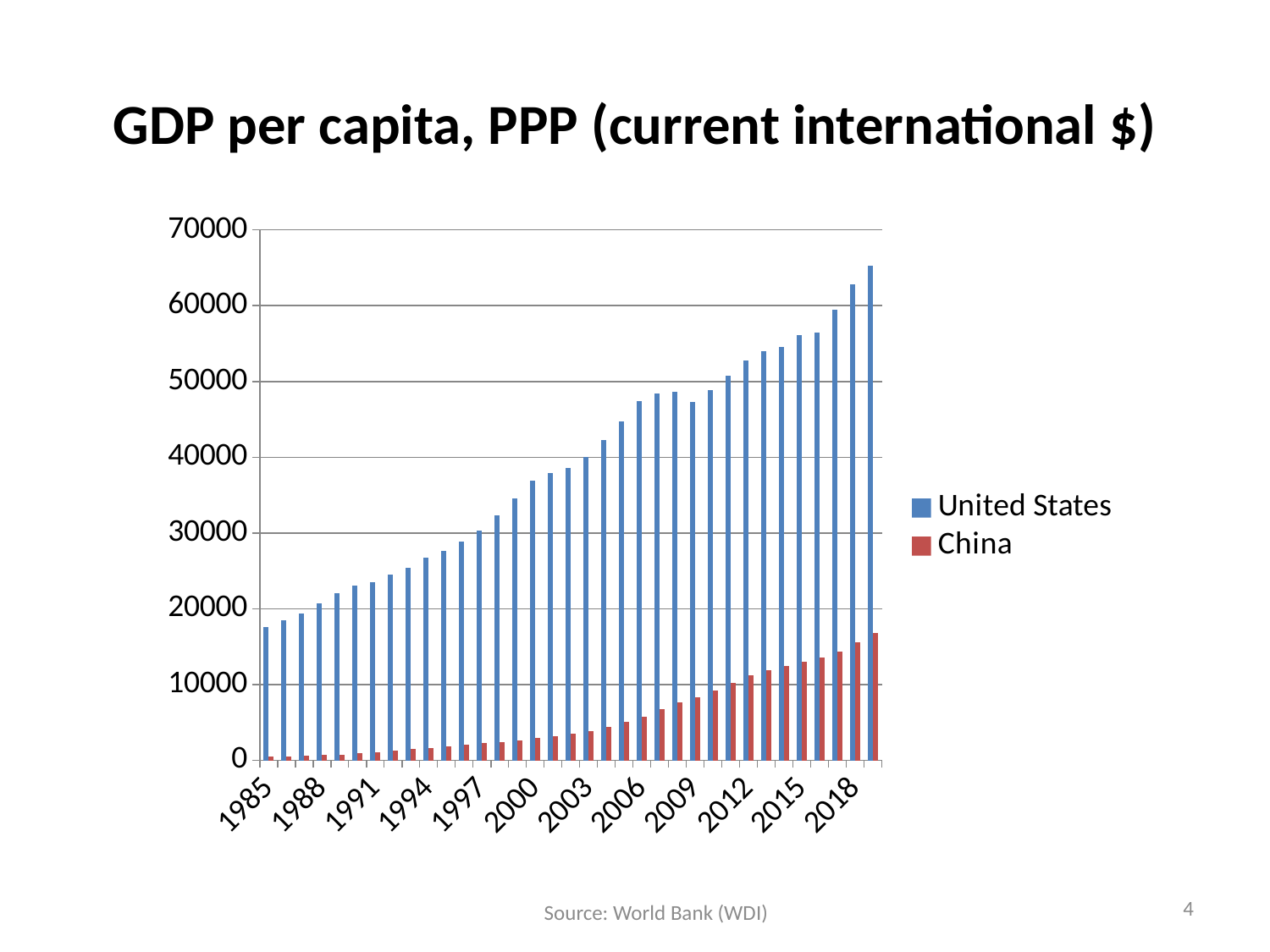
Which two series are shown in the legend? United States and China Is the value for the United States in 1985 greater or less than 20000? less Is the value for the United States in 2018 greater or less than 60000? greater What kind of chart is shown on the slide? bar chart In which year is the United States value lowest? 1985 Is the value for the United States in 2000 greater or less than 30000? greater Which series has the larger value in 2018, United States or China? United States How many series does the legend list? 2 Do the values for China rise or fall from 1985 to 2018? rise What is the title of the chart? GDP per capita, PPP (current international $)